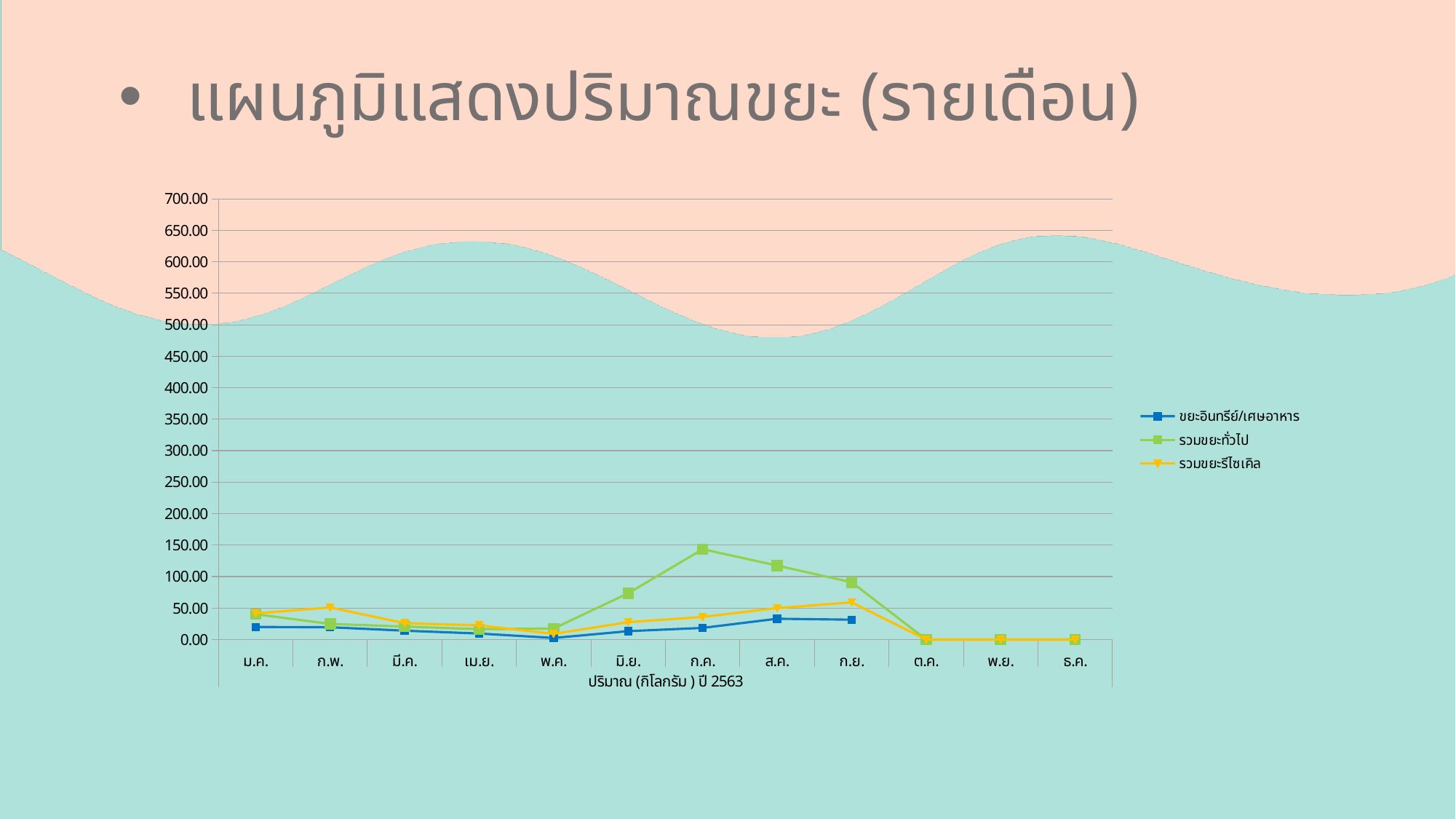
In which month does the รวมขยะทั่วไป series reach its highest value? ก.ค. What is the axis title shown below the x axis of the chart? ปริมาณ (กิโลกรัม ) ปี 2563 Does the รวมขยะทั่วไป series rise or fall from ก.ค. to ก.ย.? fall How many months are shown on the x axis of the chart? 12 What kind of chart is shown on the slide? line chart Is the value for ขยะอินทรีย์/เศษอาหาร in ส.ค. greater or less than 50.00? less Is the value for รวมขยะรีไซเคิล in ก.ย. greater or less than 50.00? greater How many series does the chart legend list? 3 What is the value for รวมขยะทั่วไป in ต.ค.? 0.00 Is the value for รวมขยะทั่วไป in ก.ค. greater or less than 100.00? greater In ก.ค., which series has the larger value: รวมขยะทั่วไป or ขยะอินทรีย์/เศษอาหาร? รวมขยะทั่วไป